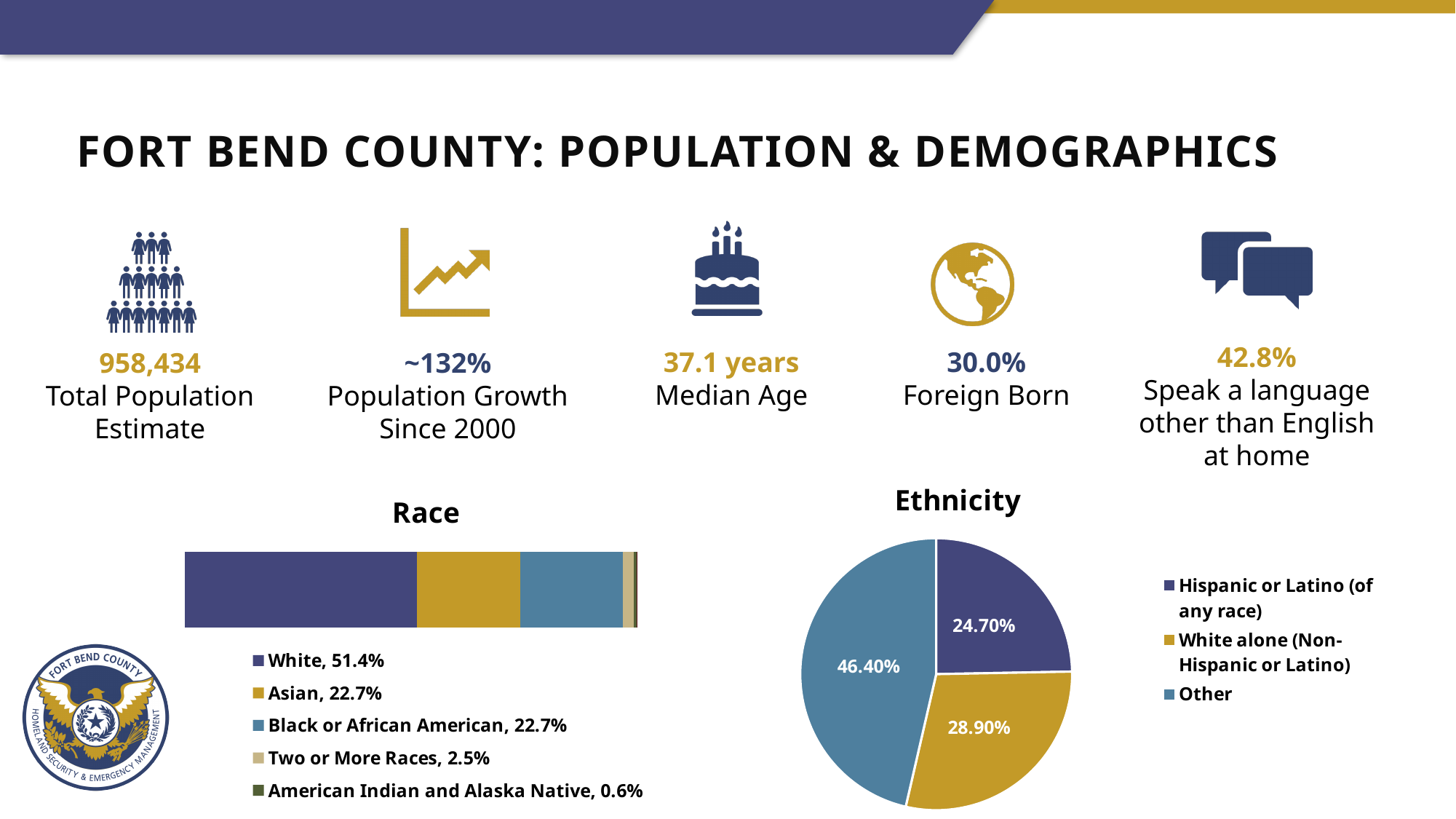
In the Ethnicity chart, which is larger: White alone (Non-Hispanic or Latino) or Hispanic or Latino (of any race)? White alone (Non-Hispanic or Latino) In the Race chart, what percentage is shown for White? 51.4% In the Ethnicity chart, which slice is the largest? Other What kind of chart is the Ethnicity chart? Pie chart In the Race chart, what percentage is shown for Two or More Races? 2.5% In the Race chart, what is the difference between the White share and the Asian share? 28.7% In the Race chart, which race category has the largest share? White What kind of chart is the Race chart? Bar chart In the Ethnicity chart, what percentage is shown for Other? 46.40% How many categories does the legend of the Race chart list? 5 In the Race chart, which race category has the smallest share? American Indian and Alaska Native In the Ethnicity chart, what percentage is shown for Hispanic or Latino (of any race)? 24.70%